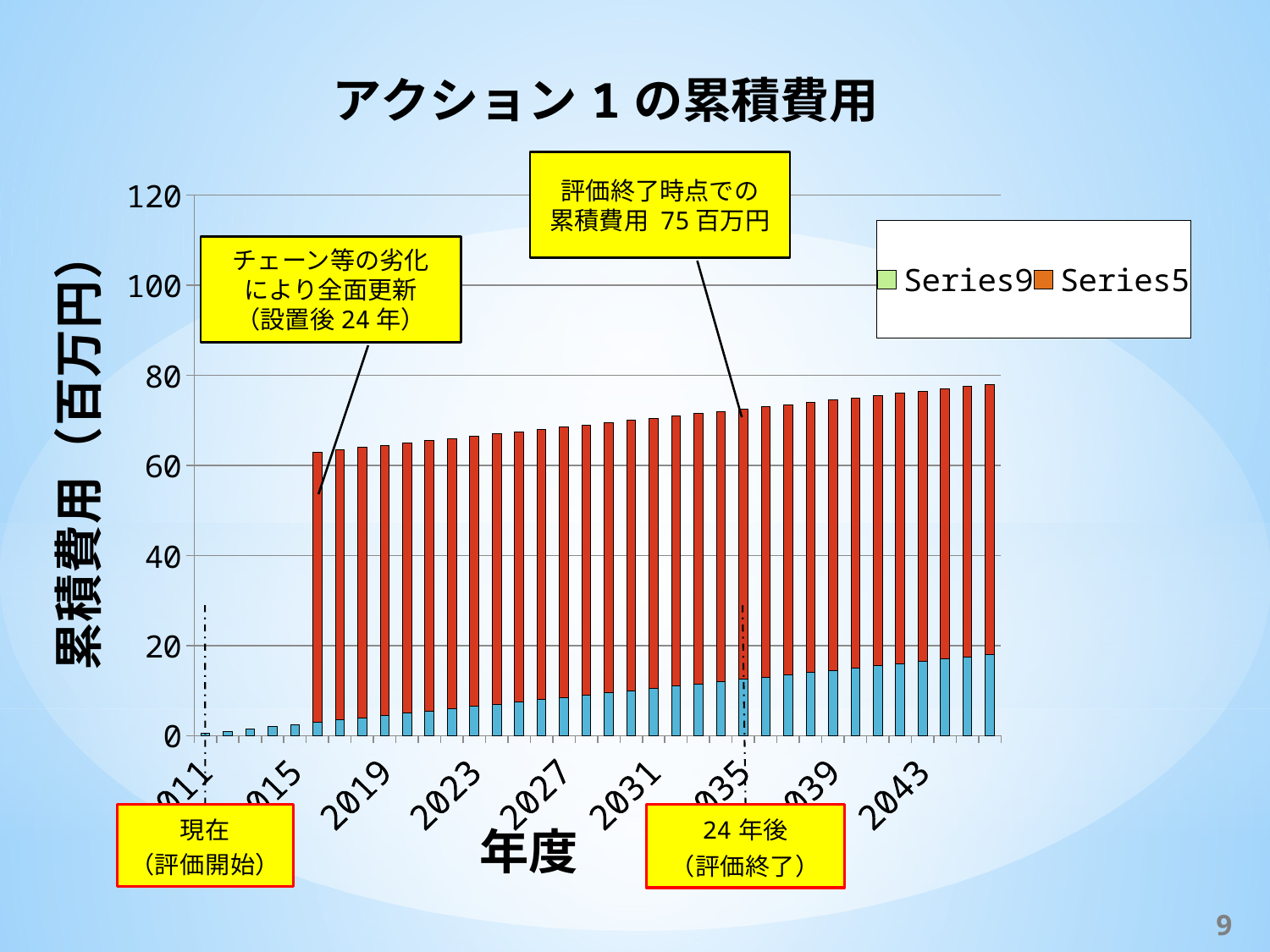
Do the bar totals rise or fall from 2011 to 2043? rise According to the annotation, what is the cumulative cost at the end of the evaluation (評価終了時点)? 75 百万円 What kind of chart is shown on the slide? bar chart How many series does the legend list? 2 Is the total bar value for 2043 greater or less than 80? less What is the title of the chart? アクション１の累積費用 What are the two legend entries? Series9, Series5 Is the total bar value for 2015 greater or less than 20? less Which year has the larger total bar, 2019 or 2043? 2043 Is the total bar value for 2031 greater or less than 60? greater Which year has the larger total bar, 2015 or 2019? 2019